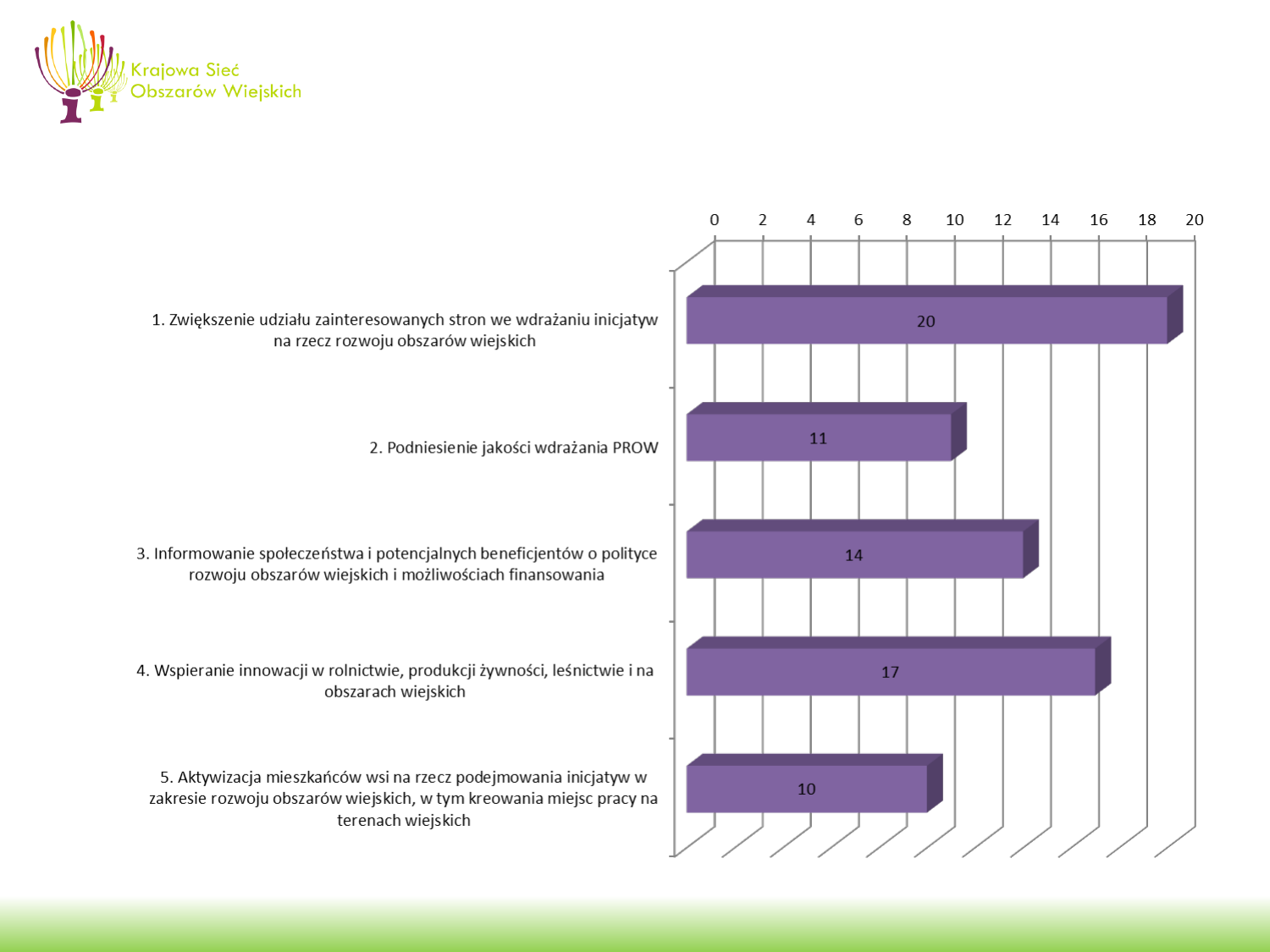
What is the difference between the values for category 4 and category 2? 6 What is the difference between the values for category 1 and category 5? 10 What kind of chart is shown on the slide? bar chart Which category has the lowest value? 5. Aktywizacja mieszkańców wsi na rzecz podejmowania inicjatyw w zakresie rozwoju obszarów wiejskich, w tym kreowania miejsc pracy na terenach wiejskich Which category has the highest value? 1. Zwiększenie udziału zainteresowanych stron we wdrażaniu inicjatyw na rzecz rozwoju obszarów wiejskich What is the value for "4. Wspieranie innowacji w rolnictwie, produkcji żywności, leśnictwie i na obszarach wiejskich"? 17 How many categories are shown in the chart? 5 What is the maximum value shown on the value axis? 20 Which has a larger value: category 2 (Podniesienie jakości wdrażania PROW) or category 3 (Informowanie społeczeństwa...)? 3. Informowanie społeczeństwa i potencjalnych beneficjentów o polityce rozwoju obszarów wiejskich i możliwościach finansowania What is the value for "2. Podniesienie jakości wdrażania PROW"? 11 What is the value for "3. Informowanie społeczeństwa i potencjalnych beneficjentów o polityce rozwoju obszarów wiejskich i możliwościach finansowania"? 14 Is the value for category 4 (Wspieranie innowacji w rolnictwie...) greater or less than 16? greater